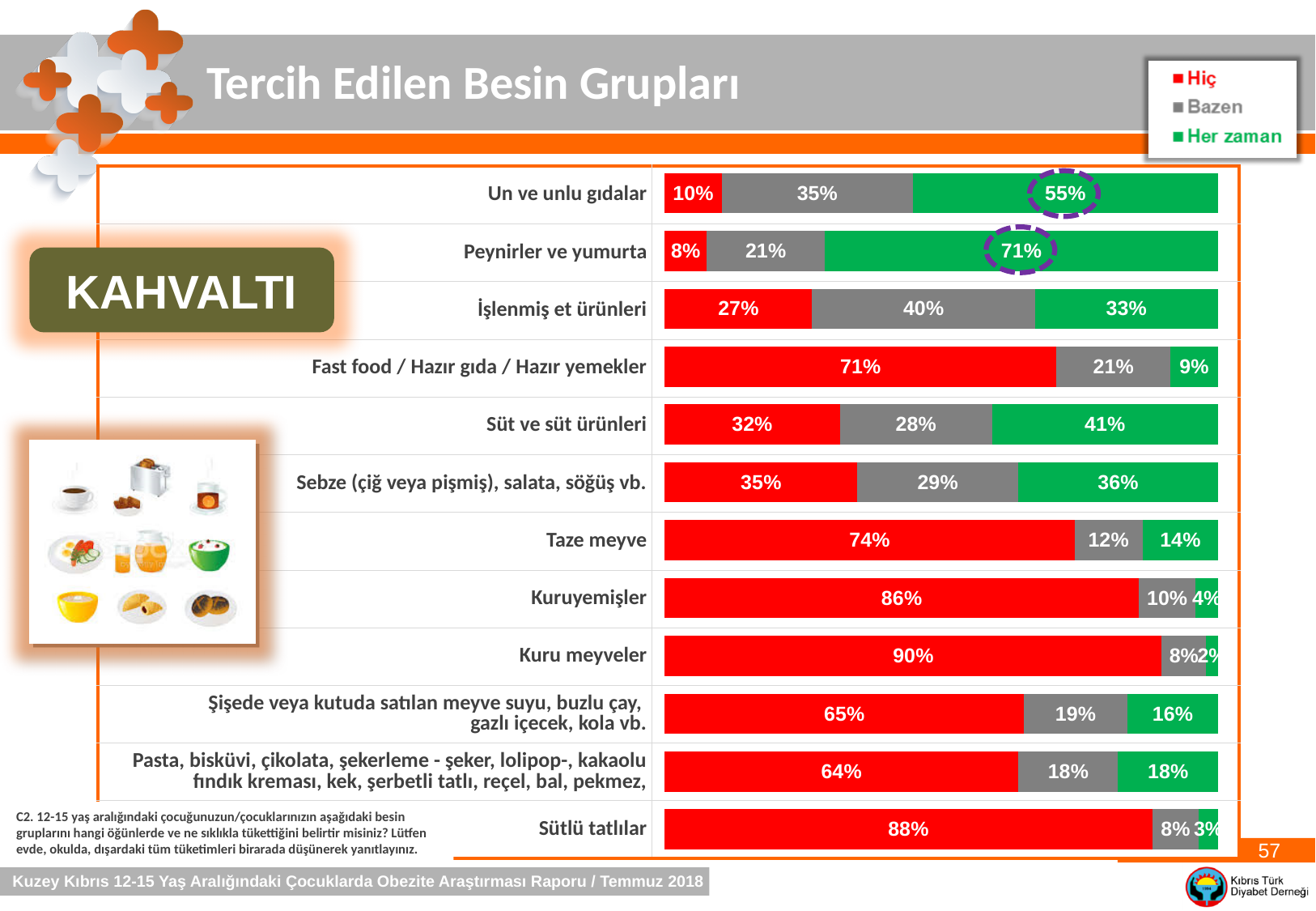
What is the 'Hiç' value for Fast food / Hazır gıda / Hazır yemekler? 71% What is the difference between the 'Hiç' values for Taze meyve and Süt ve süt ürünleri? 42% What is the 'Her zaman' value for Peynirler ve yumurta? 71% Which colour represents 'Her zaman' in the legend? Green Which category has the lowest 'Hiç' value? Peynirler ve yumurta Which category has the highest 'Hiç' value? Kuru meyveler How many food categories are shown in the chart? 12 What is the total of the stacked bar for Un ve unlu gıdalar? 100% Which is larger: the 'Her zaman' value for Un ve unlu gıdalar or for Süt ve süt ürünleri? Un ve unlu gıdalar How many series does the legend list? 3 What kind of chart is shown on the slide? Stacked bar chart What is the 'Bazen' value for İşlenmiş et ürünleri? 40%